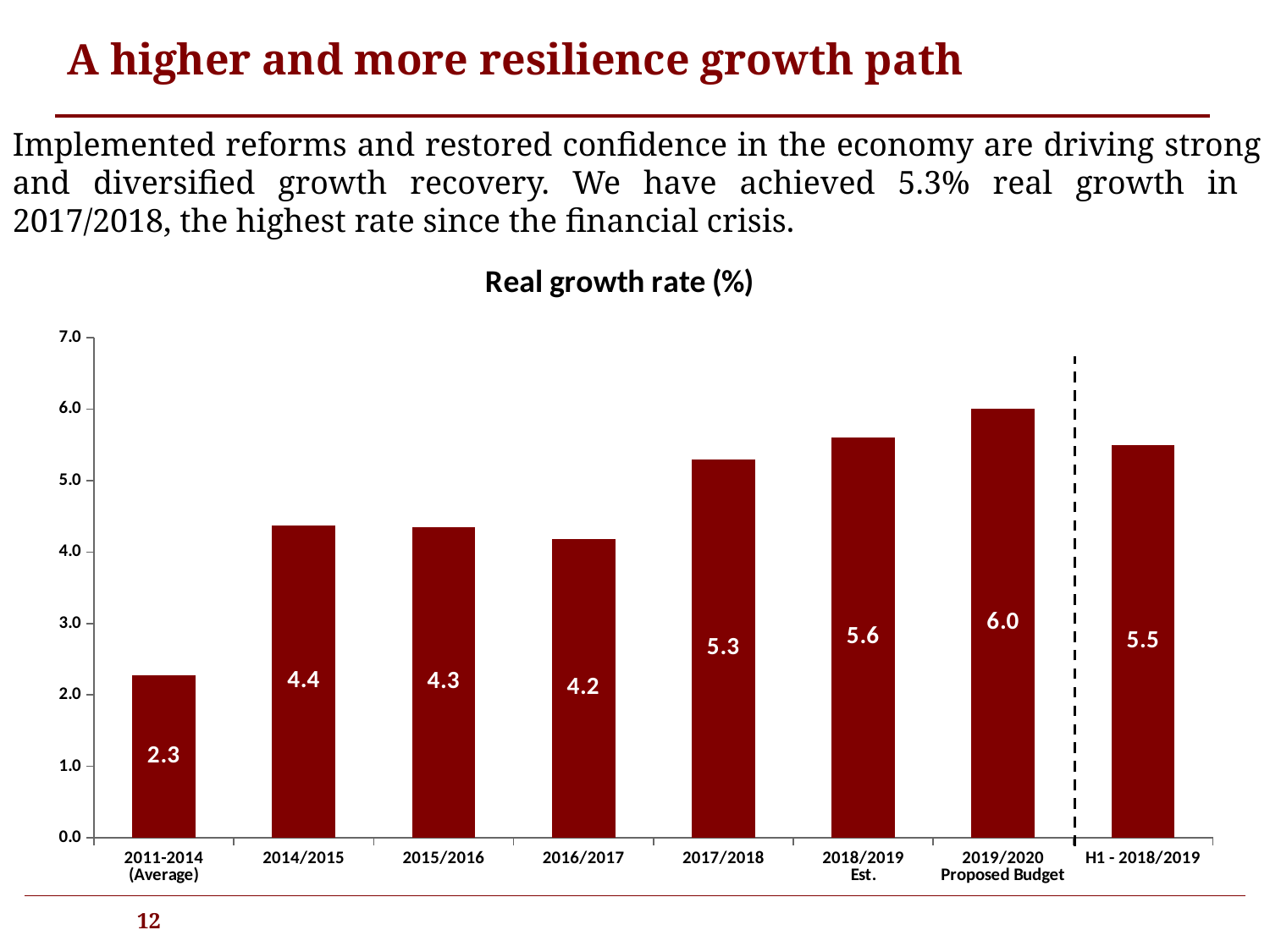
What is the real growth rate for 2017/2018? 5.3 Which category has the lowest real growth rate? 2011-2014 (Average) What is the value shown for 2019/2020 Proposed Budget? 6.0 How many bars are shown in the chart? 8 Which is larger, the value for 2017/2018 or the value for 2016/2017? 2017/2018 What is the real growth rate for H1 - 2018/2019? 5.5 Is the value for 2015/2016 greater or less than 5.0? less What is the difference between the values for 2018/2019 Est. and 2011-2014 (Average)? 3.3 What is the title of the chart? Real growth rate (%) What kind of chart is shown on the slide? bar chart Which category has the highest real growth rate? 2019/2020 Proposed Budget Do the values generally rise or fall from 2016/2017 to 2019/2020 Proposed Budget? rise